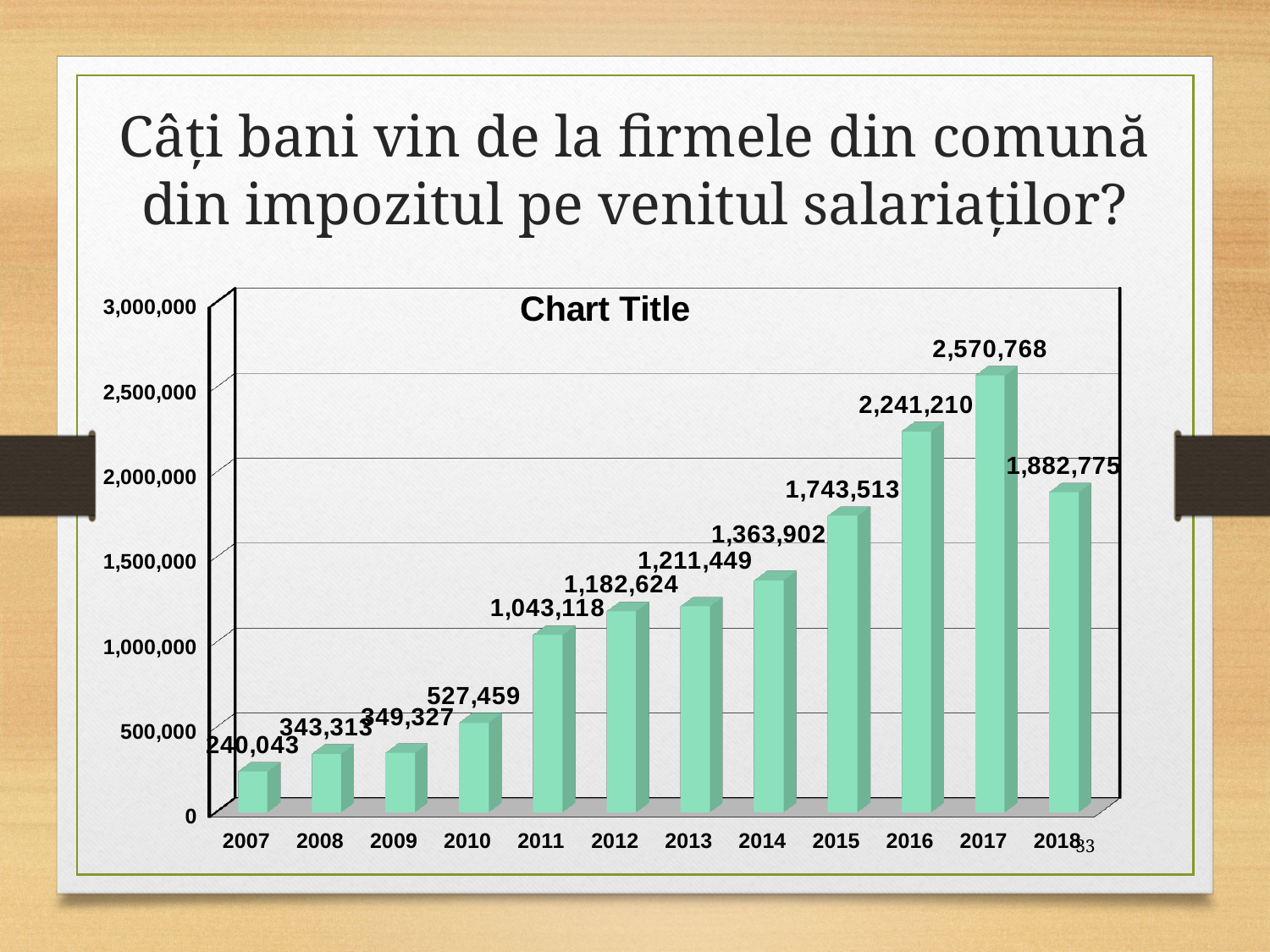
What is the value for 2017? 2,570,768 Which year has the highest value? 2017 What is the value for 2011? 1,043,118 What is the value for 2018? 1,882,775 How many years are shown on the x axis? 12 What kind of chart is shown on the slide? bar chart What is the difference between the values for 2017 and 2016? 329,558 What is the difference between the values for 2017 and 2018? 687,993 Is the value for 2010 greater or less than 1,000,000? less Which year has the lowest value? 2007 What is the value for 2007? 240,043 Which is larger, the value for 2015 or the value for 2014? 2015